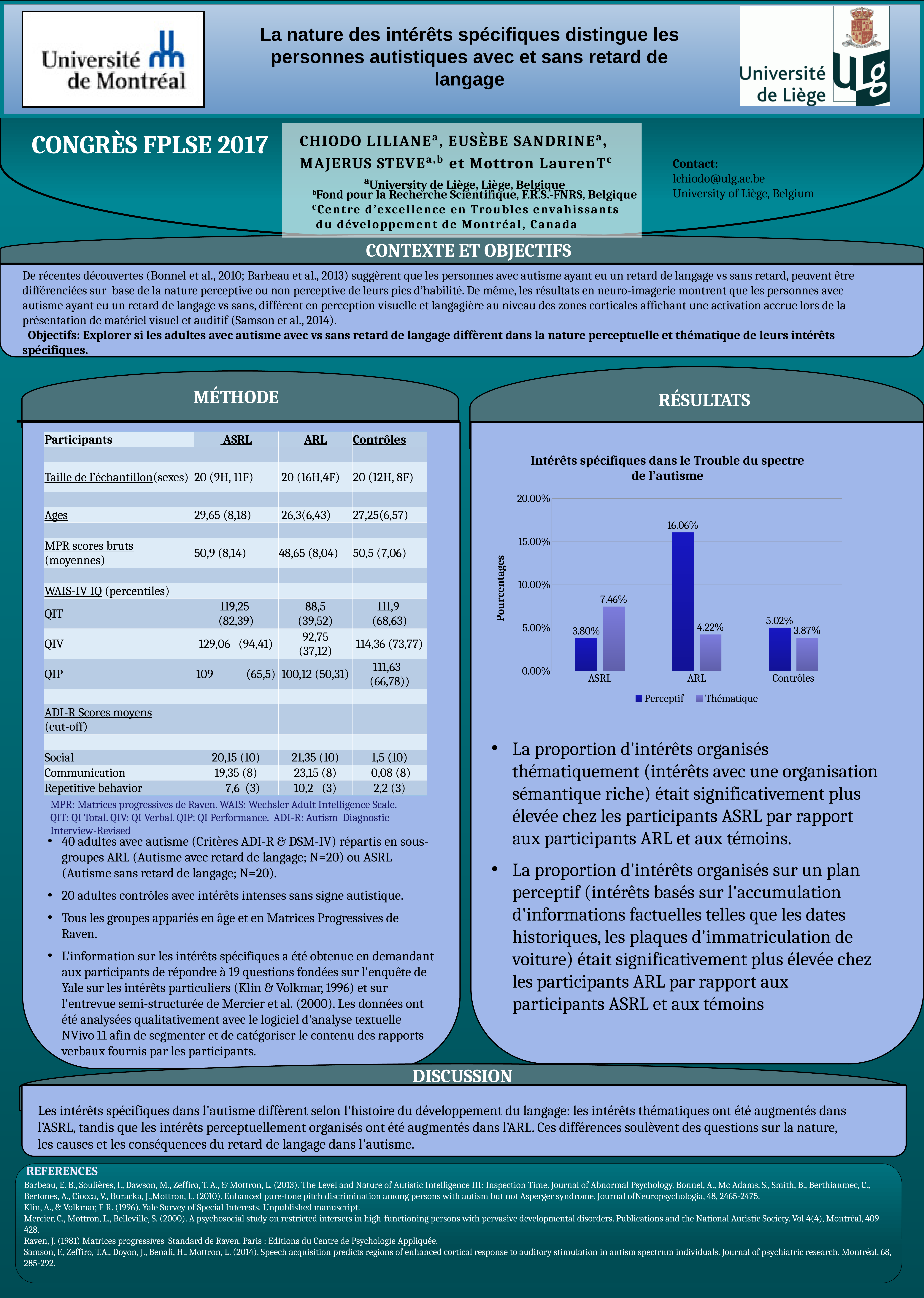
What is the Perceptif value for Contrôles? 5.02% What is the difference between the Perceptif values for ARL and ASRL? 12.26% What is the Perceptif value for ARL? 16.06% How many series does the legend list? 2 For ASRL, which is larger: the Perceptif value or the Thématique value? Thématique Is the Perceptif value for ARL greater or less than 15.00%? greater What is the Thématique value for ARL? 4.22% Which group has the lowest Thématique value? Contrôles What type of chart is shown? Bar chart What is the Thématique value for ASRL? 7.46% How many groups are shown on the x axis? 3 Which group has the highest Perceptif value? ARL